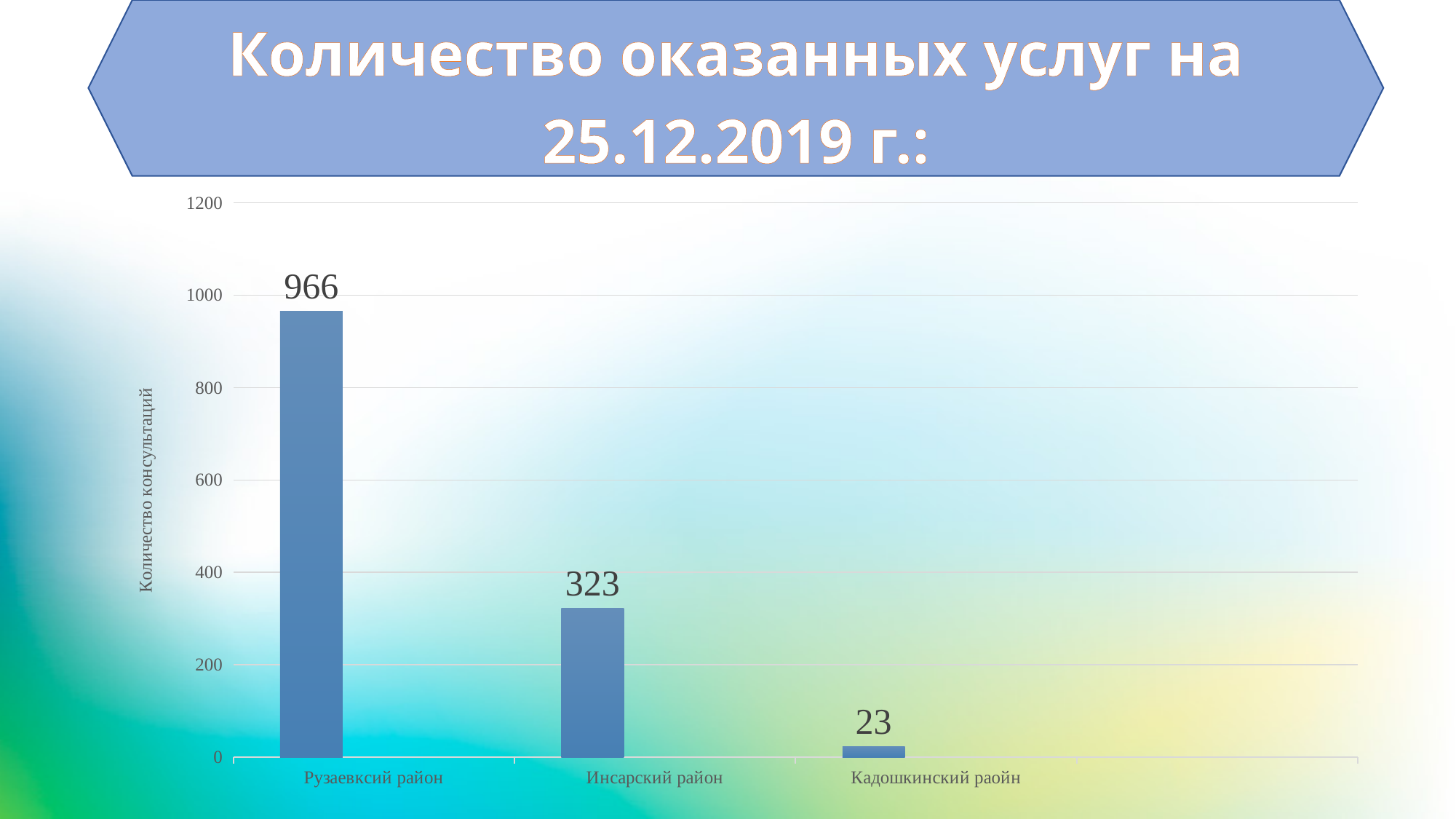
What kind of chart is shown on the slide? bar chart What is the difference between the values for Рузаевксий район and Инсарский район? 643 What is the value for Инсарский район? 323 Which district has the highest number of consultations? Рузаевксий район How many districts are shown on the chart? 3 What is the difference between the values for Инсарский район and Кадошкинский раойн? 300 Which is larger, the value for Инсарский район or the value for Кадошкинский раойн? Инсарский район What is the label of the vertical axis? Количество консультаций What is the value for Рузаевксий район? 966 Is the value for Рузаевксий район greater or less than 800? greater Which district has the lowest number of consultations? Кадошкинский раойн What is the value for Кадошкинский раойн? 23